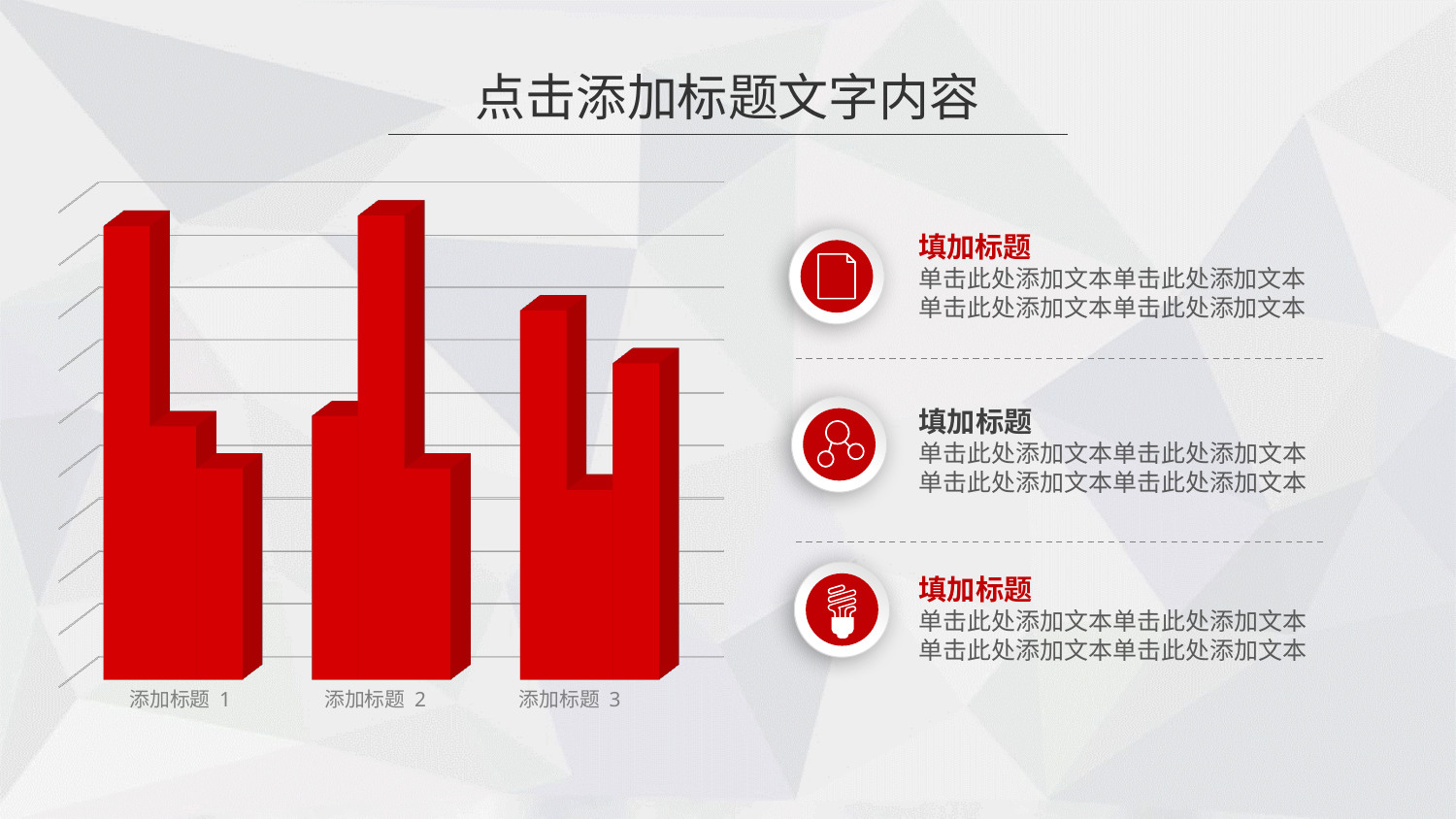
In the bar chart, within the category 添加标题 2, which bar is taller, the left one or the right one? the right one In the bar chart, which category has the shortest first (left) bar? 添加标题 2 What is the label of the third category on the x axis of the bar chart? 添加标题 3 In the bar chart, which category has the tallest second (right) bar? 添加标题 2 What is the label of the first category on the x axis of the bar chart? 添加标题 1 In the bar chart, is the first bar of 添加标题 1 taller or shorter than the first bar of 添加标题 3? taller How many categories are shown on the x axis of the bar chart? 3 In the bar chart, within the category 添加标题 1, which bar is shorter, the left one or the right one? the right one What kind of chart is shown on the left of the slide? bar chart